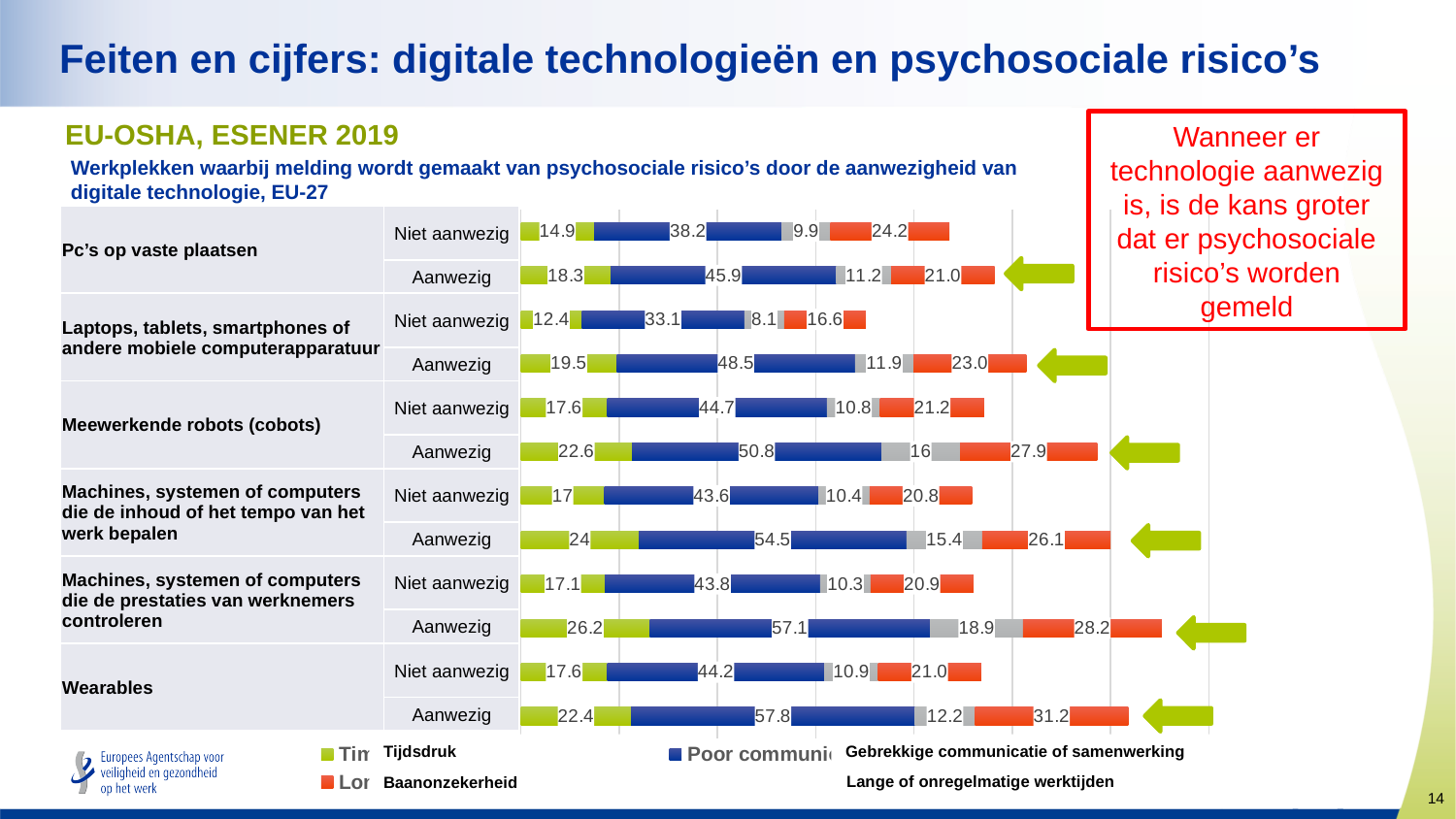
What is the last (orange) segment value for 'Meewerkende robots (cobots)' when 'Aanwezig'? 27.9 What is the difference in the Tijdsdruk (green) value between 'Aanwezig' and 'Niet aanwezig' for 'Machines, systemen of computers die de prestaties van werknemers controleren'? 9.1 Which bar has the lowest Tijdsdruk (green) value? Laptops, tablets, smartphones of andere mobiele computerapparatuur – Niet aanwezig (12.4) What kind of chart is shown on the slide? Stacked bar chart What is the Tijdsdruk (green) value for 'Laptops, tablets, smartphones of andere mobiele computerapparatuur' when 'Niet aanwezig'? 12.4 What is the blue (Gebrekkige communicatie of samenwerking) value for 'Wearables' when 'Aanwezig'? 57.8 How many bars are plotted in the chart? 12 What is the Tijdsdruk (green) value for 'Pc's op vaste plaatsen' when the technology is 'Aanwezig'? 18.3 What is the total of the stacked bar for 'Pc's op vaste plaatsen' – 'Niet aanwezig'? 87.2 Which bar has the highest Tijdsdruk (green) value? Machines, systemen of computers die de prestaties van werknemers controleren – Aanwezig (26.2) What is the total of the stacked bar for 'Laptops, tablets, smartphones of andere mobiele computerapparatuur' – 'Niet aanwezig'? 70.2 For 'Wearables', is the blue segment larger for 'Aanwezig' or 'Niet aanwezig'? Aanwezig